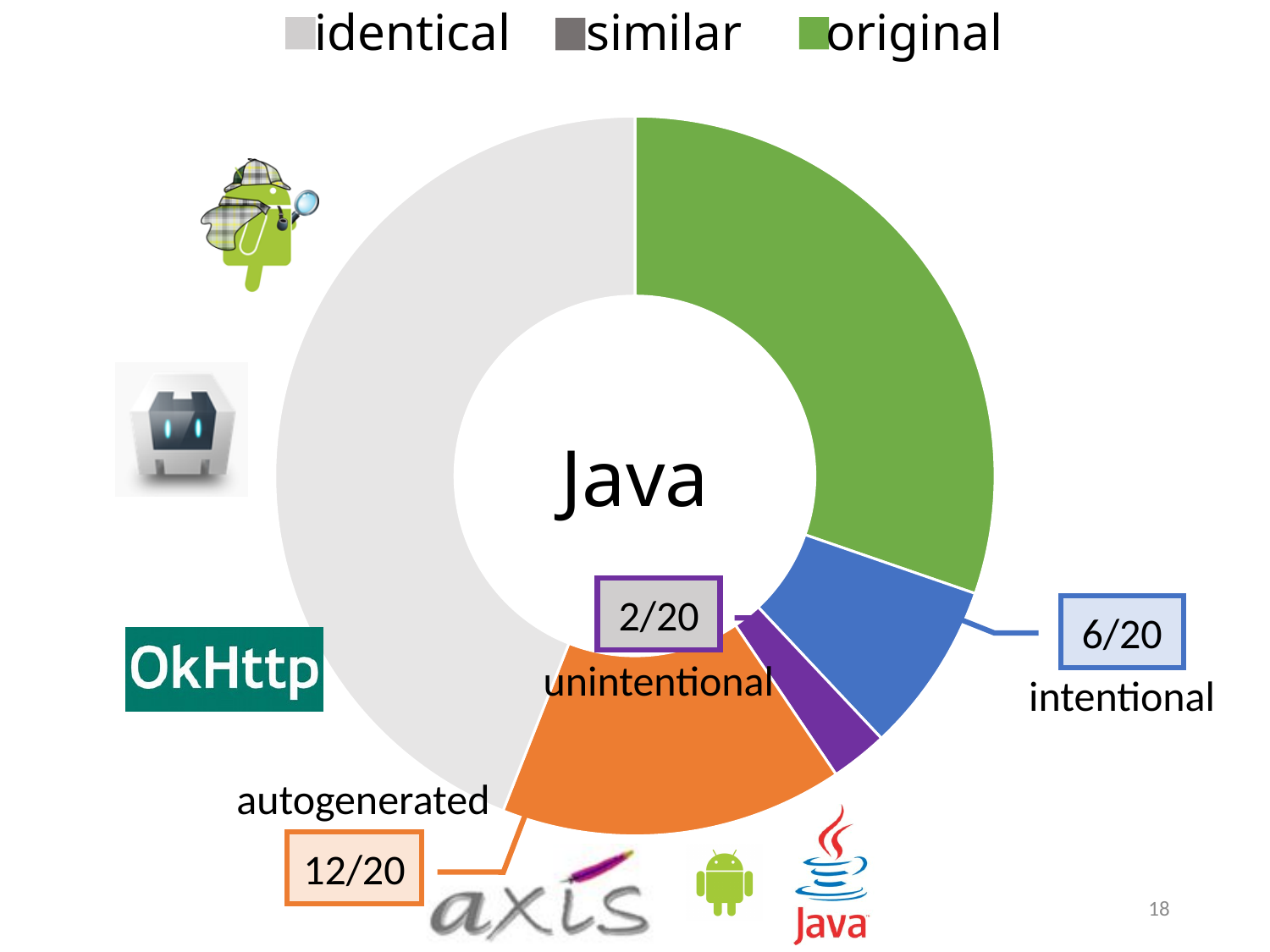
Of the three labelled slices (intentional, unintentional, autogenerated), which has the smallest value? unintentional Of the three labelled slices (intentional, unintentional, autogenerated), which has the largest value? autogenerated What value is labelled for the unintentional slice? 2/20 What value is labelled for the autogenerated slice? 12/20 Which is larger, the autogenerated slice or the intentional slice? autogenerated What word is written in the centre of the doughnut chart? Java How many entries does the legend list? 3 What value is labelled for the intentional slice? 6/20 What kind of chart is shown on the slide? doughnut chart How many more out of 20 does the autogenerated slice have than the intentional slice? 6 Which legend entry is shown in green? original